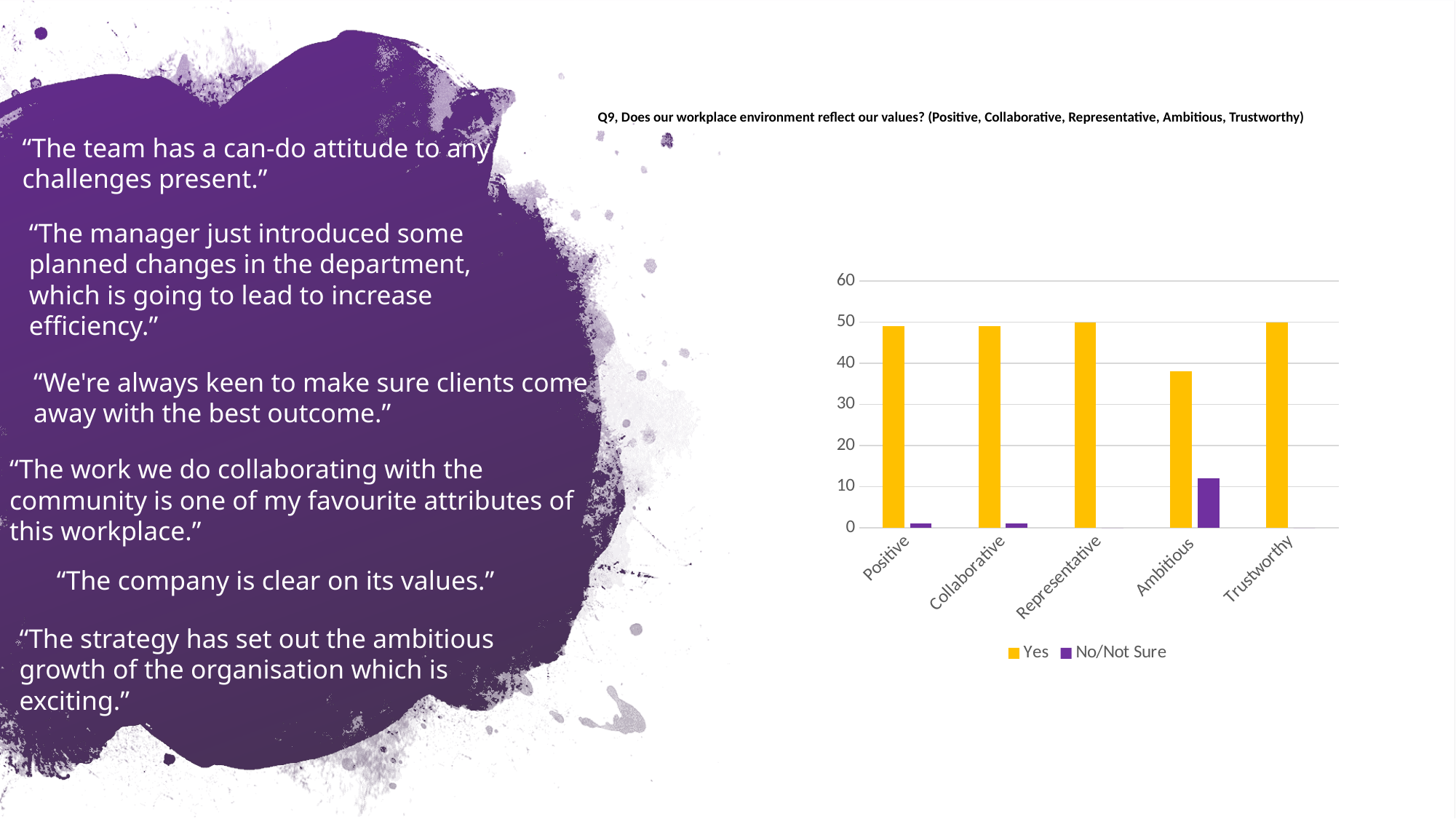
Which is larger, the Yes value for Positive or the Yes value for Ambitious? Positive Is the No/Not Sure value for Ambitious greater or less than 10? greater Which category has the lowest Yes value? Ambitious What question number does the chart title refer to? Q9 Which series is shown in purple in the chart? No/Not Sure How many categories are shown on the x axis of the chart? 5 Which category has the highest No/Not Sure value? Ambitious Is the Yes value for Ambitious greater or less than 40? less Is the Yes value for Positive greater or less than 40? greater How many series does the chart legend list? 2 What kind of chart is shown on the slide? bar chart